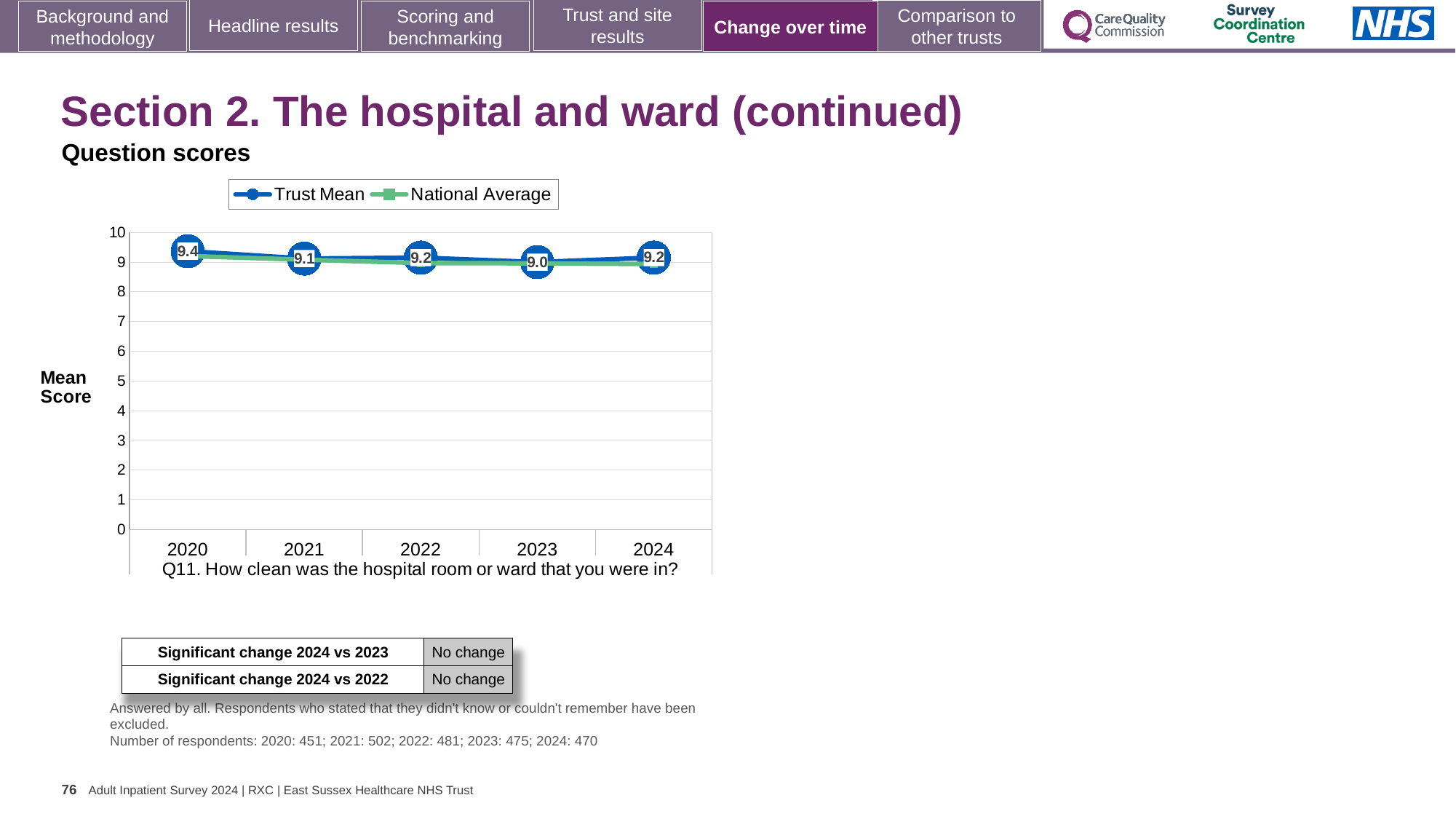
Does the Trust Mean rise or fall from 2020 to 2023? fall How many series does the chart legend list? 2 What is the difference between the Trust Mean in 2020 and in 2023? 0.4 In which year is the Trust Mean lowest? 2023 What kind of chart is shown on the slide? line chart How many years are shown on the x axis of the chart? 5 In which year is the Trust Mean highest? 2020 Which year has the larger Trust Mean, 2021 or 2022? 2022 Is the National Average value for 2020 greater or less than 8? greater What is the Trust Mean score for 2020? 9.4 What is the Trust Mean score for 2024? 9.2 What is the Trust Mean score for 2023? 9.0